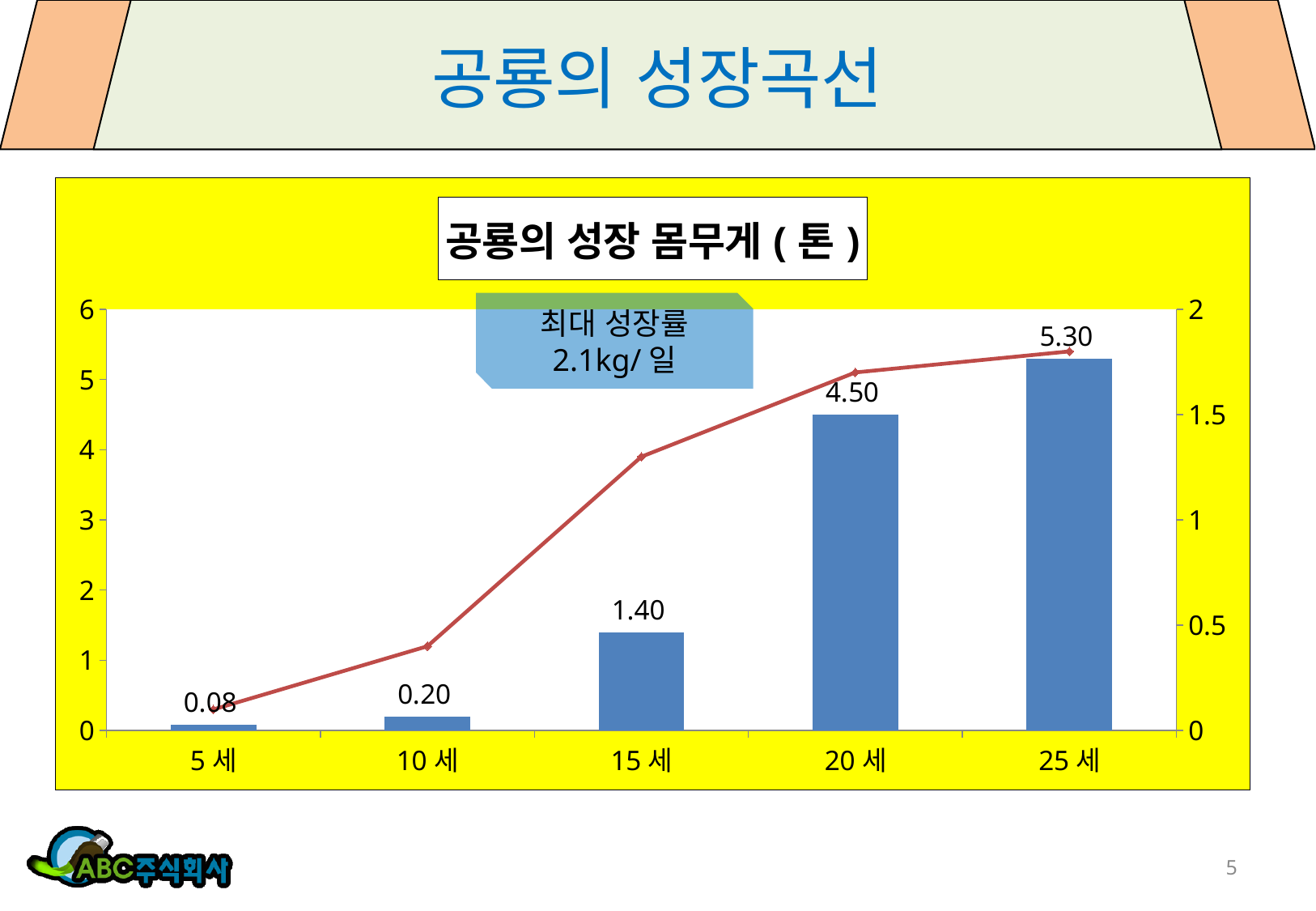
What is the bar value for 20 세? 4.50 What is the title of the chart? 공룡의 성장 몸무게 ( 톤 ) Do the bar values rise or fall as age increases along the x axis? rise What is the difference between the bar values for 25 세 and 20 세? 0.80 What is the bar value for 5 세? 0.08 Which age category has the highest bar value? 25 세 What is the bar value for 15 세? 1.40 What maximum growth rate is stated in the callout box on the chart? 2.1kg/ 일 How many age categories are shown on the x axis? 5 On the right-hand axis, is the red line's value at 15 세 greater or less than 1? greater Which has a larger bar value, 10 세 or 15 세? 15 세 Which age category has the lowest bar value? 5 세